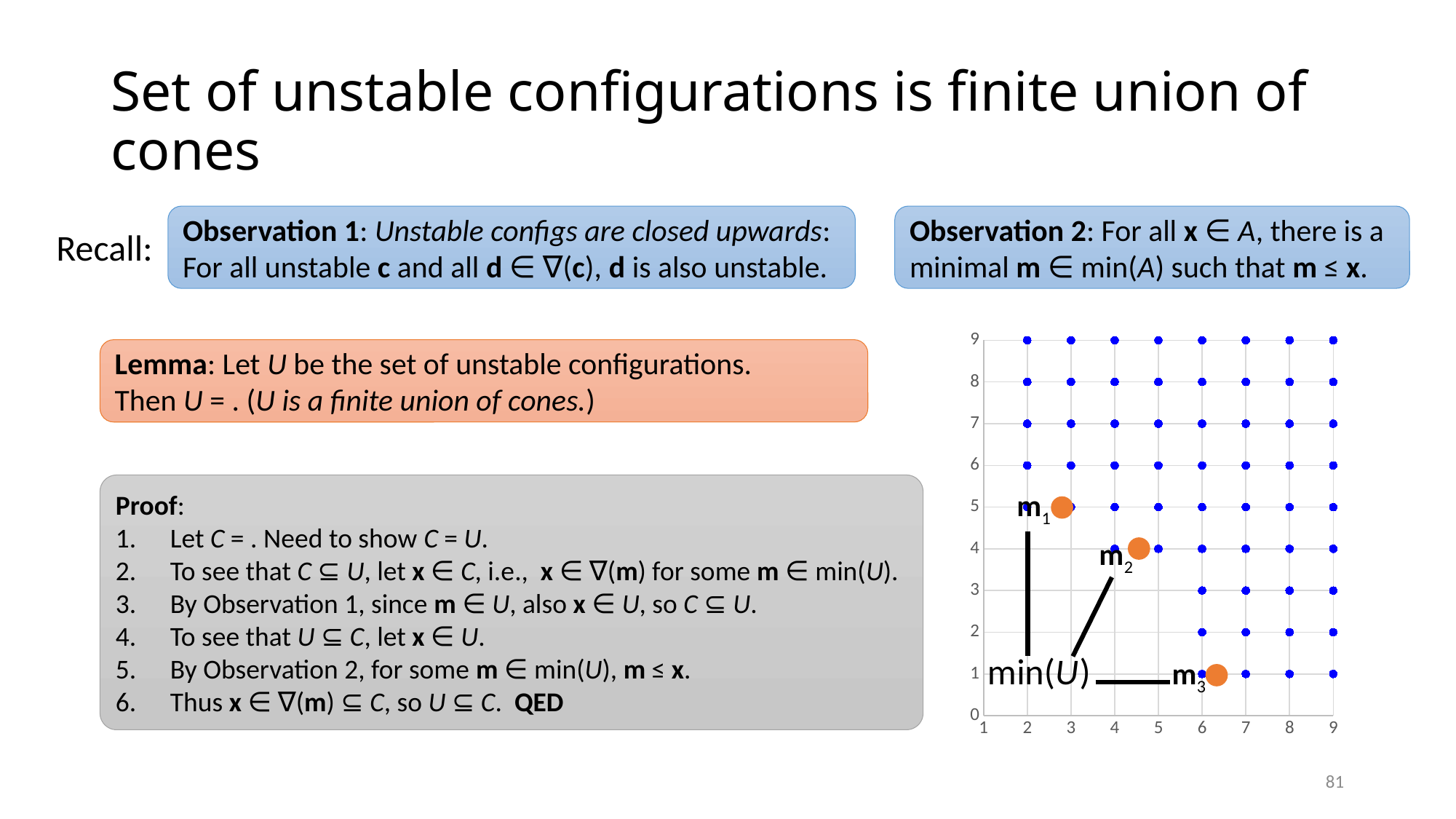
Which of the labeled points m1, m2, m3 has the largest x-value on the chart? m3 Which of the labeled points m1, m2, m3 has the highest y-value on the chart? m1 Is the x-value of point m3 greater or less than 5? greater Which has the higher y-value on the chart, m1 or m2? m1 Which of the labeled points m1, m2, m3 has the lowest y-value on the chart? m3 What label is written next to the lines pointing to the orange points on the chart? min(U) Which has the larger x-value on the chart, m1 or m2? m2 What kind of chart is shown on the right of the slide? scatter chart How many orange labeled points (m1, m2, m3) are shown on the chart? 3 Is the y-value of point m1 greater or less than 4? greater What is the highest value shown on the y-axis of the chart? 9 Is the y-value of point m3 greater or less than 2? less